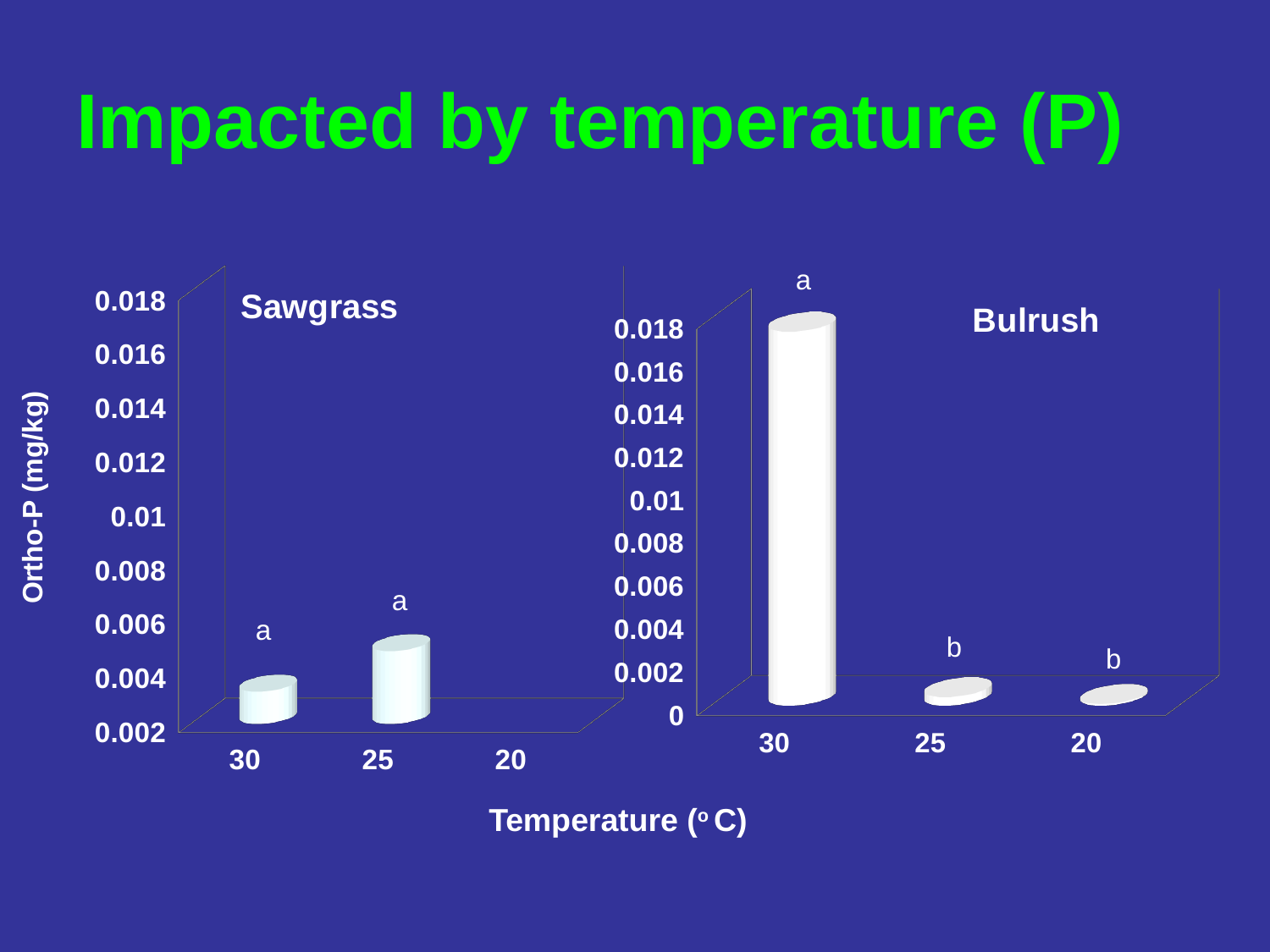
In the Bulrush chart, is the value at 30 greater or less than 0.01? greater What is the label on the y axis of the charts? Ortho-P (mg/kg) In the Bulrush chart, which temperature has the lowest Ortho-P value? 25 and 20 (tied at 0) In the Sawgrass chart, is the value at 30 greater or less than 0.006? less In the Bulrush chart, do the values rise or fall going from 30 to 20 along the x axis? fall In the Sawgrass chart, is the value at 25 greater or less than 0.008? less How many temperature categories are shown on the x axis of the Bulrush chart? 3 What kind of chart is the Sawgrass chart? bar chart In the Bulrush chart, which temperature has the highest Ortho-P value? 30 What is the label on the x axis shared by the two charts? Temperature (°C) In the Sawgrass chart, which is larger, the value at 30 or the value at 25? 25